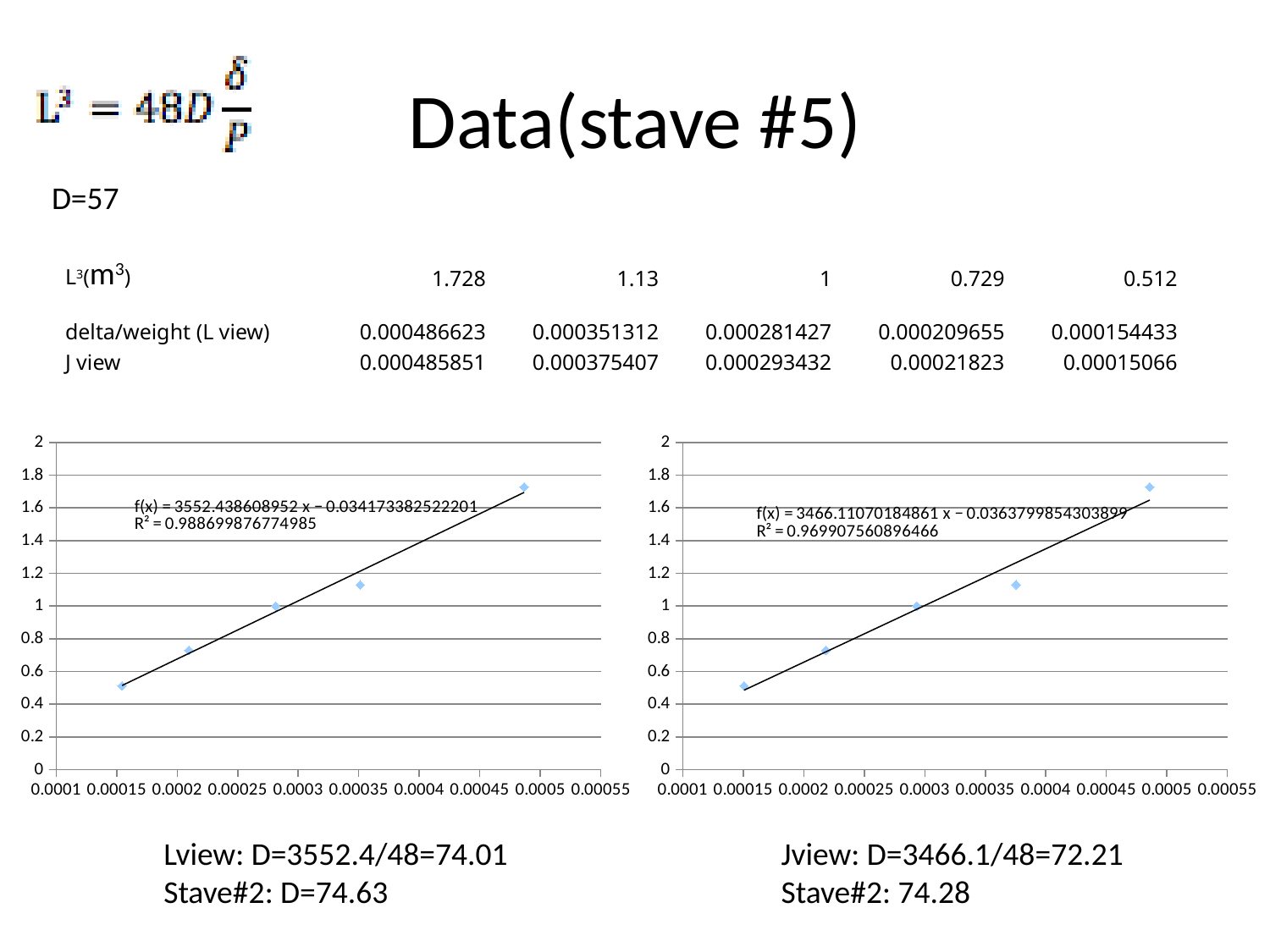
In the right chart, do the plotted values rise or fall as x increases? rise How many data points are plotted in the left chart? 5 What trendline equation is shown on the right chart? f(x) = 3466.11070184861 x − 0.0363799854303899 How many data points are plotted in the right chart? 5 What R² value is shown on the left chart? R² = 0.988699876774985 In the right chart, is the y value of the leftmost point greater or less than 0.6? less In the left chart, which point has the higher y value: the one near x = 0.0002 or the one near x = 0.00028? the one near x = 0.00028 In the left chart, is the y value of the point near x = 0.00035 greater or less than 1.2? less In the right chart, is the y value of the point near x = 0.0003 greater or less than 0.8? greater In the left chart, do the plotted values rise or fall as x increases? rise What kind of chart is the left chart on the slide? scatter chart